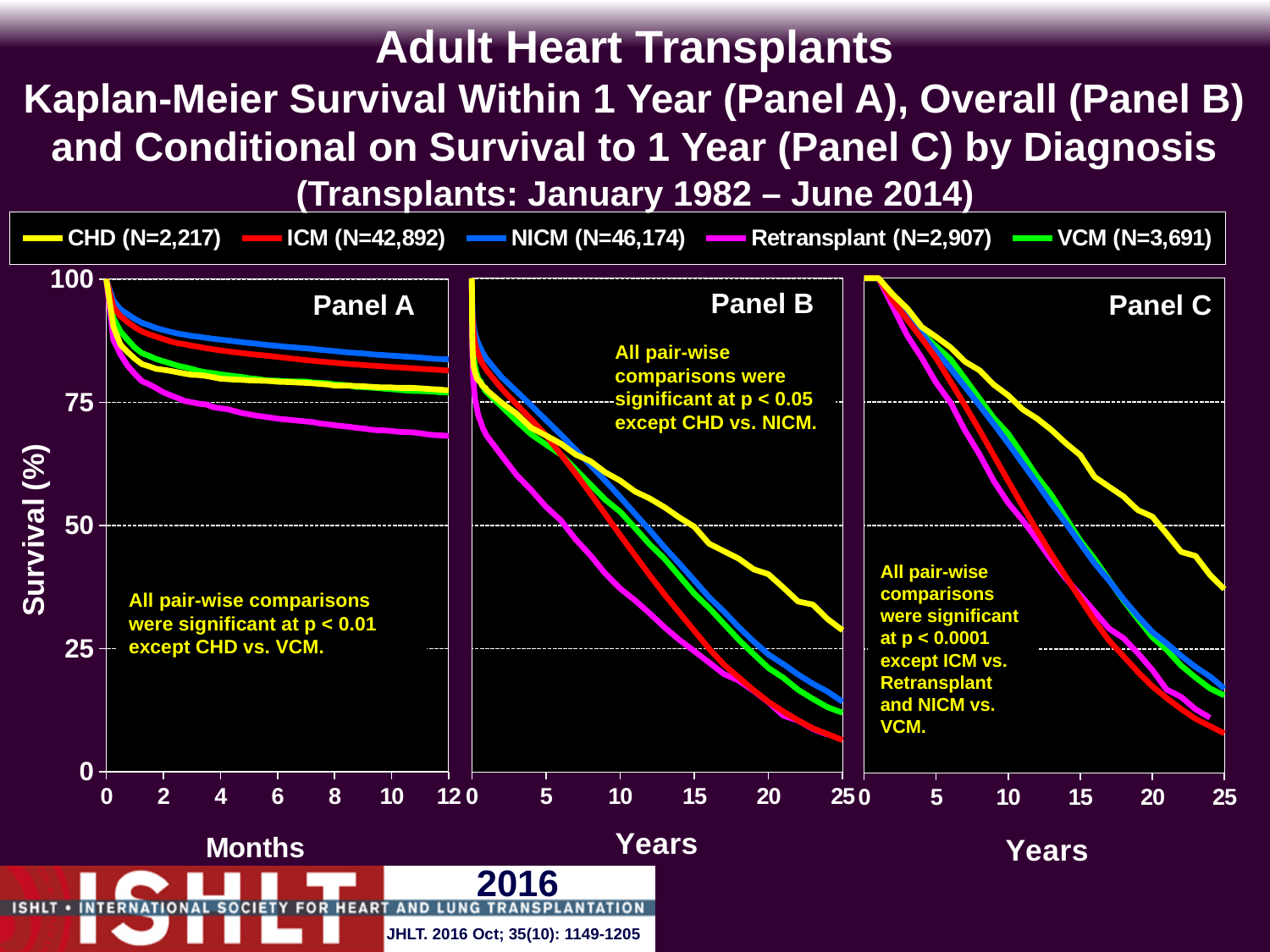
In Panel B, do the survival curves rise or fall as years increase? Fall In Panel A, which diagnosis group has the lowest survival at 12 months? Retransplant In Panel B, which diagnosis group has the highest survival at 25 years? CHD What kind of chart is shown in Panel A? Line chart In Panel C, is the survival for CHD at 25 years greater or less than 25? greater In Panel A, is the survival for Retransplant at 12 months greater or less than 75? less In Panel B, is the survival for Retransplant at 10 years greater or less than 50? less According to the legend, what is the N for ICM? N=42,892 In Panel C, which is higher at 20 years, the survival for CHD or for ICM? CHD In Panel A, which diagnosis group has the highest survival at 12 months? NICM In Panel B, which diagnosis group has the lowest survival at 25 years? ICM How many series does the legend list? 5